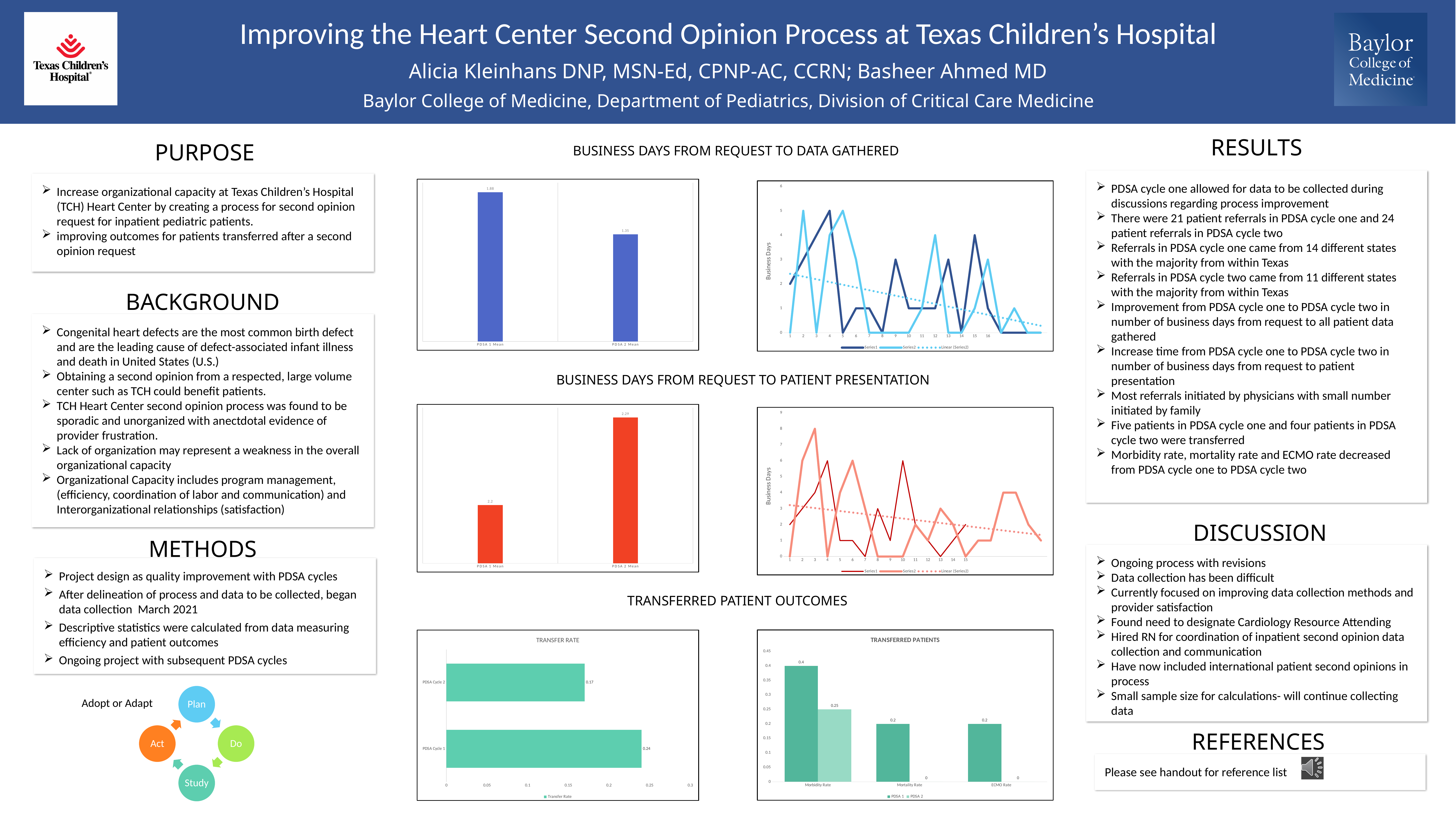
In the 'TRANSFER RATE' chart, what is the value for PDSA Cycle 2? 0.17 In the 'TRANSFERRED PATIENTS' chart, what is the PDSA 1 value for Morbidity Rate? 0.4 In the bar chart under 'BUSINESS DAYS FROM REQUEST TO PATIENT PRESENTATION', which bar is higher, PDSA 1 Mean or PDSA 2 Mean? PDSA 2 Mean In the bar chart under 'BUSINESS DAYS FROM REQUEST TO DATA GATHERED', what is the difference between PDSA 1 Mean and PDSA 2 Mean? 0.53 In the bar chart under 'BUSINESS DAYS FROM REQUEST TO PATIENT PRESENTATION', what is the value for PDSA 2 Mean? 2.29 In the bar chart under 'BUSINESS DAYS FROM REQUEST TO DATA GATHERED', what is the value for PDSA 2 Mean? 1.35 How many series does the legend of the 'TRANSFERRED PATIENTS' chart list? 2 In the 'TRANSFER RATE' chart, what is the value for PDSA Cycle 1? 0.24 In the 'TRANSFERRED PATIENTS' chart, what is the PDSA 2 value for Mortality Rate? 0 What kind of chart is the 'TRANSFER RATE' chart? Bar chart How many entries does the legend of the line chart under 'BUSINESS DAYS FROM REQUEST TO DATA GATHERED' list? 3 In the bar chart under 'BUSINESS DAYS FROM REQUEST TO DATA GATHERED', what is the value for PDSA 1 Mean? 1.88